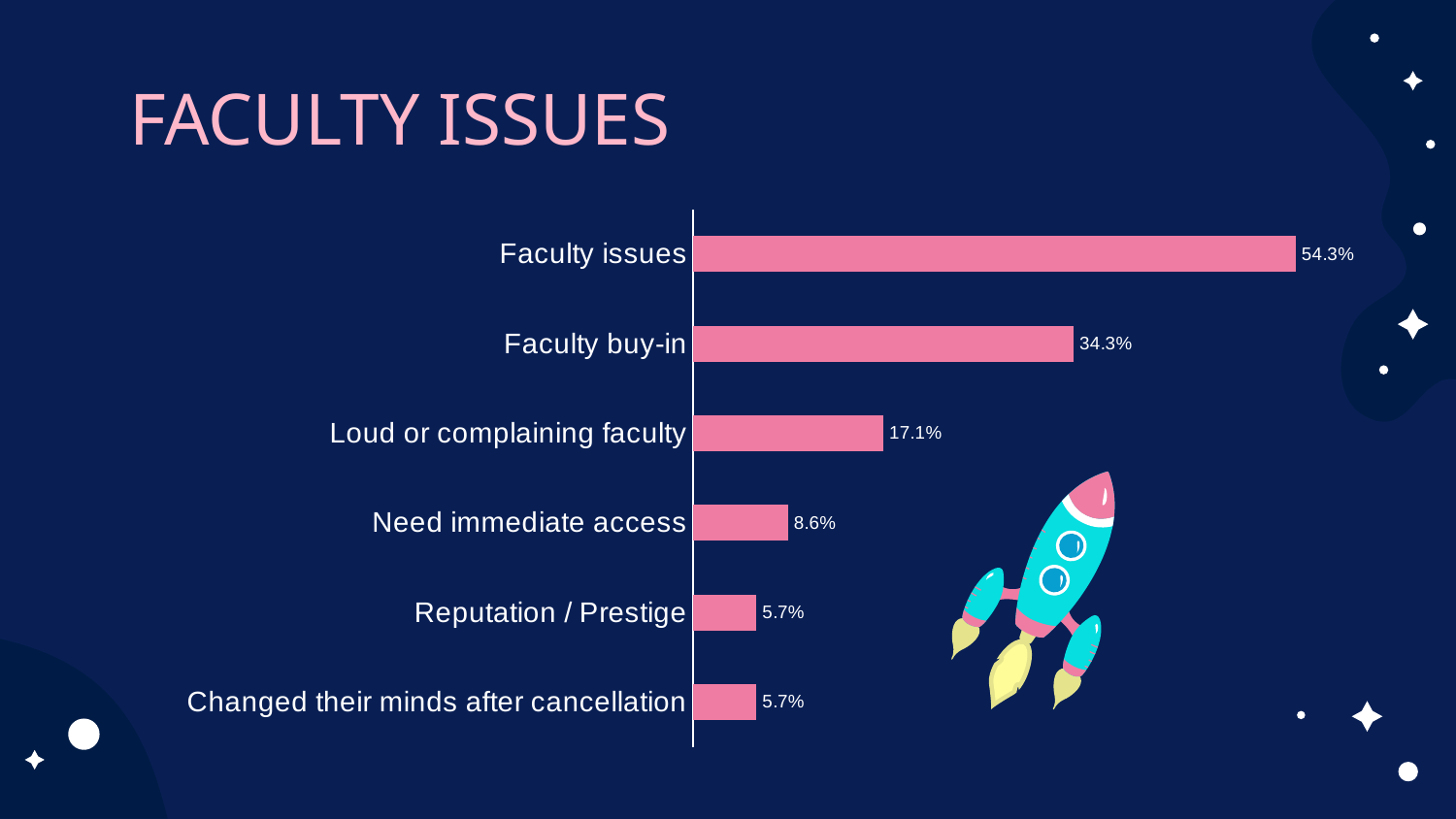
What kind of chart is shown on the slide? Bar chart What is the value for Faculty issues? 54.3% Which is larger, Faculty buy-in or Loud or complaining faculty? Faculty buy-in What value is shown for both Reputation / Prestige and Changed their minds after cancellation? 5.7% What is the value for Need immediate access? 8.6% What is the title of the slide? FACULTY ISSUES How many categories are shown in the chart? 6 What is the difference between Loud or complaining faculty and Need immediate access? 8.5% What is the value for Faculty buy-in? 34.3% Which category has the highest value? Faculty issues What is the value for Loud or complaining faculty? 17.1% What is the difference between Faculty issues and Faculty buy-in? 20.0%